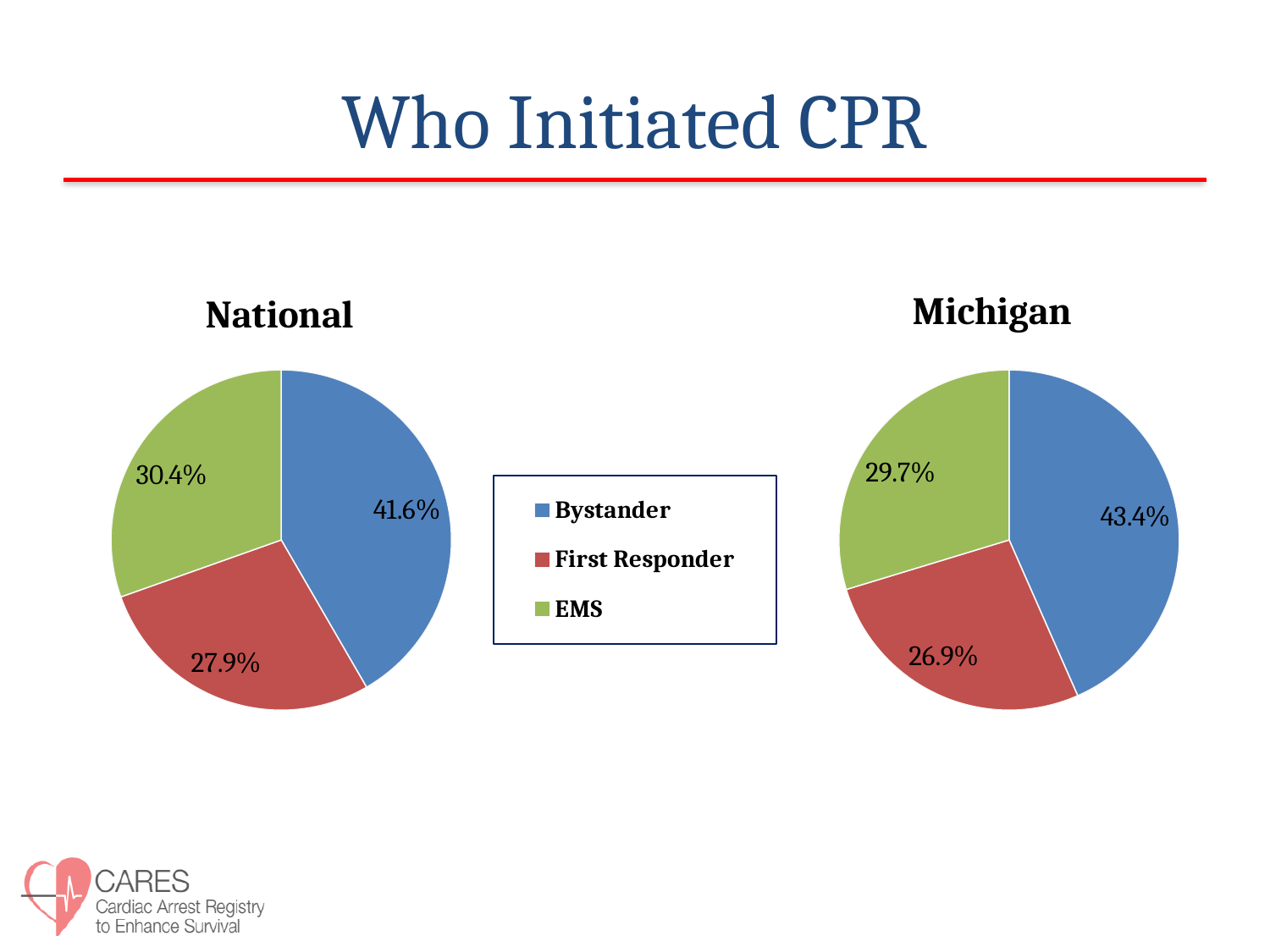
How many categories does each pie chart show? 3 What type of chart is used for the National and Michigan data? Pie chart What is the difference between the Bystander share in the Michigan chart and the Bystander share in the National chart? 1.8% What is the title of the slide? Who Initiated CPR Is the First Responder share larger in the National chart or the Michigan chart? National In the Michigan pie chart, which category has the largest share? Bystander In the National pie chart, what share of CPR was initiated by Bystanders? 41.6% In the National pie chart, what is the difference between the EMS share and the First Responder share? 2.5% In the National pie chart, which category has the smallest share? First Responder Which colour represents EMS in the legend? Green In the National pie chart, what share of CPR was initiated by First Responders? 27.9% In the Michigan pie chart, what share of CPR was initiated by EMS? 29.7%